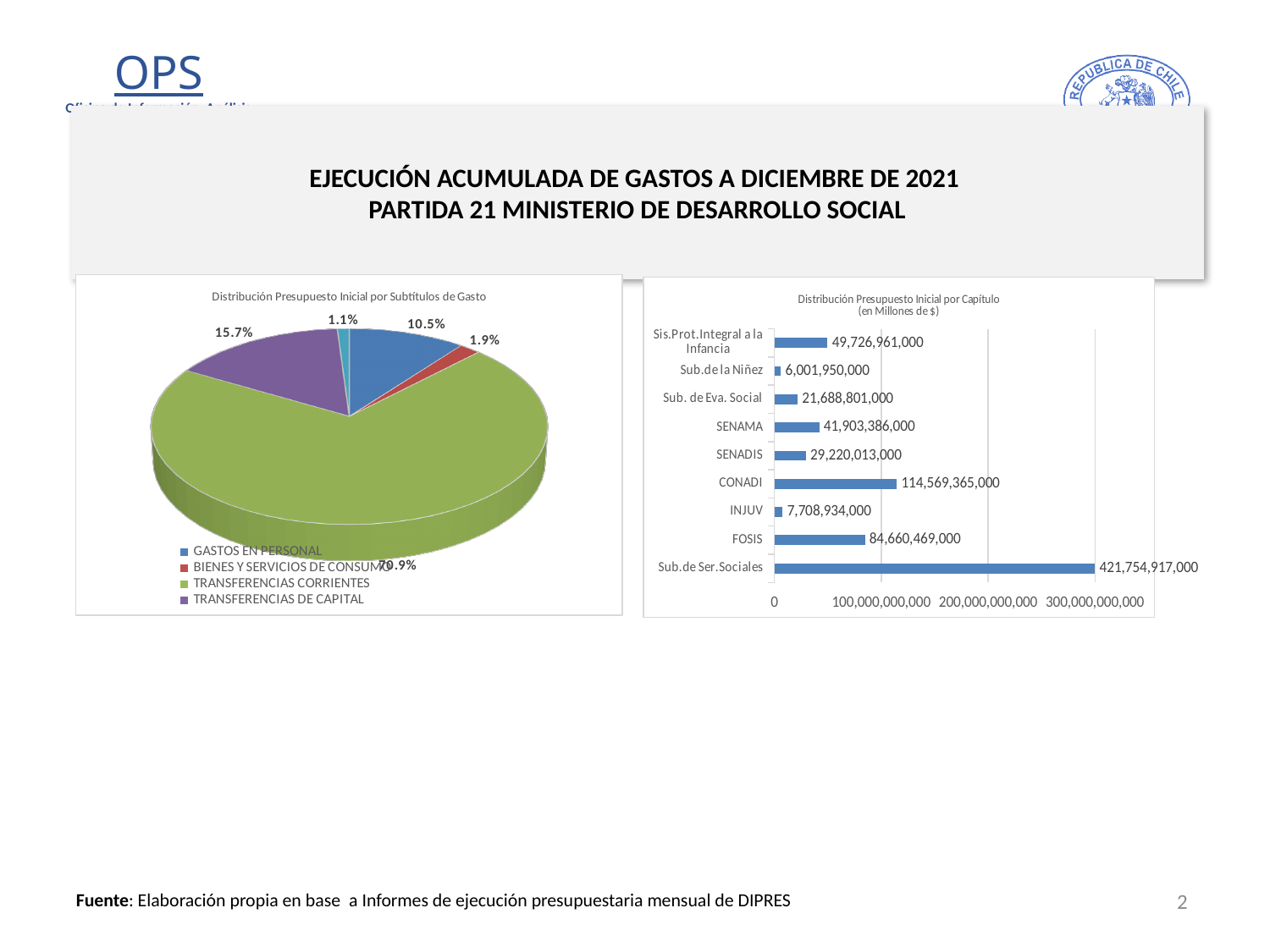
In the bar chart 'Distribución Presupuesto Inicial por Capítulo', what is the value for SENAMA? 41,903,386,000 In the bar chart 'Distribución Presupuesto Inicial por Capítulo', which category has the highest value? Sub.de Ser.Sociales In the bar chart 'Distribución Presupuesto Inicial por Capítulo', which is larger: the value for Sis.Prot.Integral a la Infancia or the value for Sub. de Eva. Social? Sis.Prot.Integral a la Infancia In the bar chart 'Distribución Presupuesto Inicial por Capítulo', what is the value for CONADI? 114,569,365,000 In the bar chart 'Distribución Presupuesto Inicial por Capítulo', what is the value for FOSIS? 84,660,469,000 In the bar chart 'Distribución Presupuesto Inicial por Capítulo', which category has the lowest value? Sub.de la Niñez In the pie chart 'Distribución Presupuesto Inicial por Subtítulos de Gasto', what share does TRANSFERENCIAS CORRIENTES have? 70.9% In the bar chart 'Distribución Presupuesto Inicial por Capítulo', is the value for Sub.de Ser.Sociales greater or less than 300,000,000,000? greater What type of chart is the chart on the right of the slide, 'Distribución Presupuesto Inicial por Capítulo'? bar chart How many categories are shown in the bar chart 'Distribución Presupuesto Inicial por Capítulo'? 9 In the pie chart 'Distribución Presupuesto Inicial por Subtítulos de Gasto', what share does TRANSFERENCIAS DE CAPITAL have? 15.7% In the bar chart 'Distribución Presupuesto Inicial por Capítulo', what is the difference between the values for SENAMA and SENADIS? 12,683,373,000